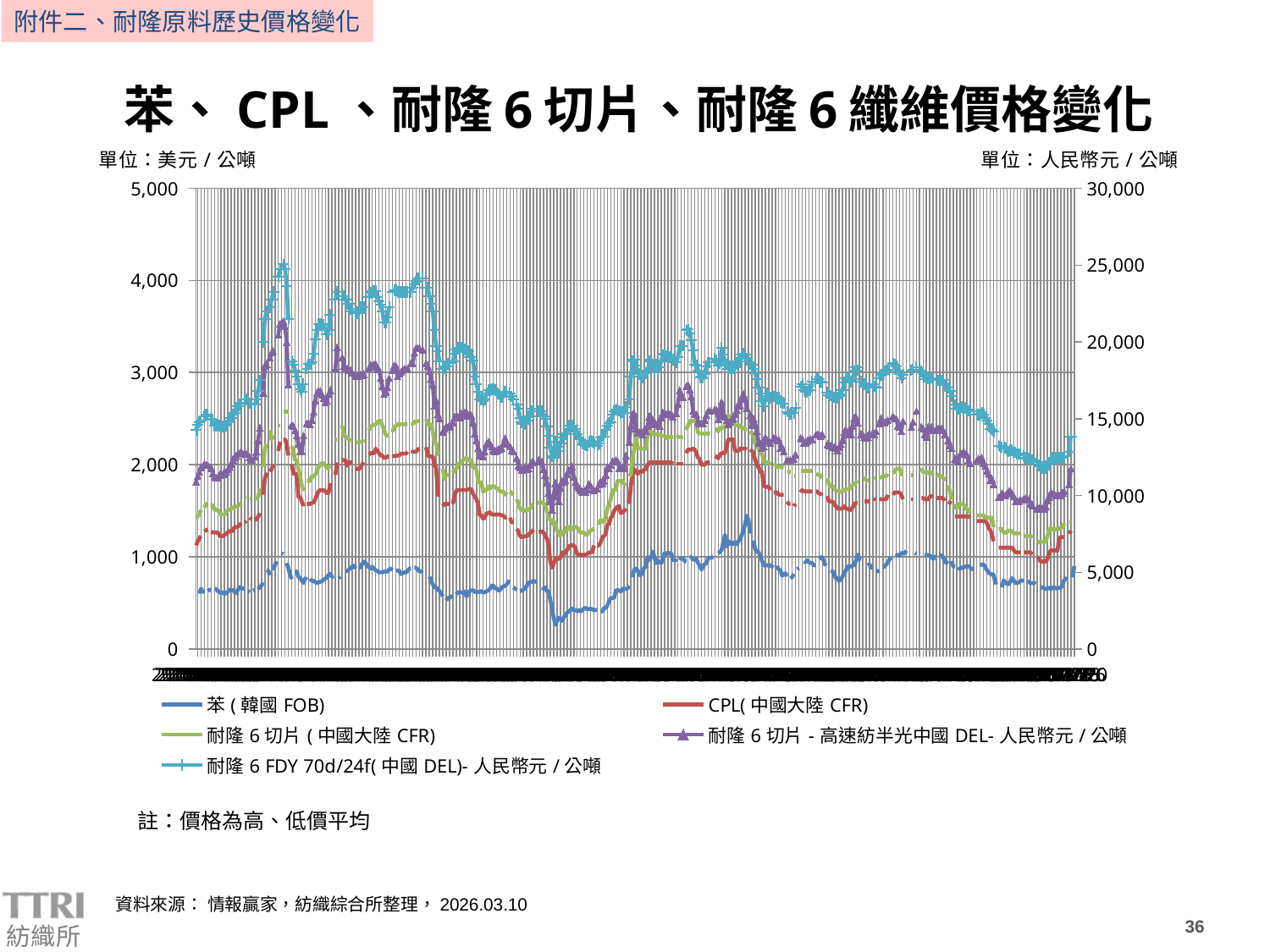
Which series stays lowest across the whole chart? 苯 ( 韓國 FOB) What is the maximum value shown on the left vertical axis? 5,000 Which series is plotted higher, CPL( 中國大陸 CFR) or 苯 ( 韓國 FOB)? CPL( 中國大陸 CFR) Which series is plotted higher, 耐隆 6 切片 ( 中國大陸 CFR) or CPL( 中國大陸 CFR)? 耐隆 6 切片 ( 中國大陸 CFR) What unit is given for the left vertical axis? 美元 / 公噸 What unit is given for the right vertical axis? 人民幣元 / 公噸 What kind of chart is shown on the slide? line chart How many series does the legend list? 5 Which series is plotted highest across the chart? 耐隆 6 FDY 70d/24f( 中國 DEL)- 人民幣元 / 公噸 What is the maximum value shown on the right vertical axis? 30,000